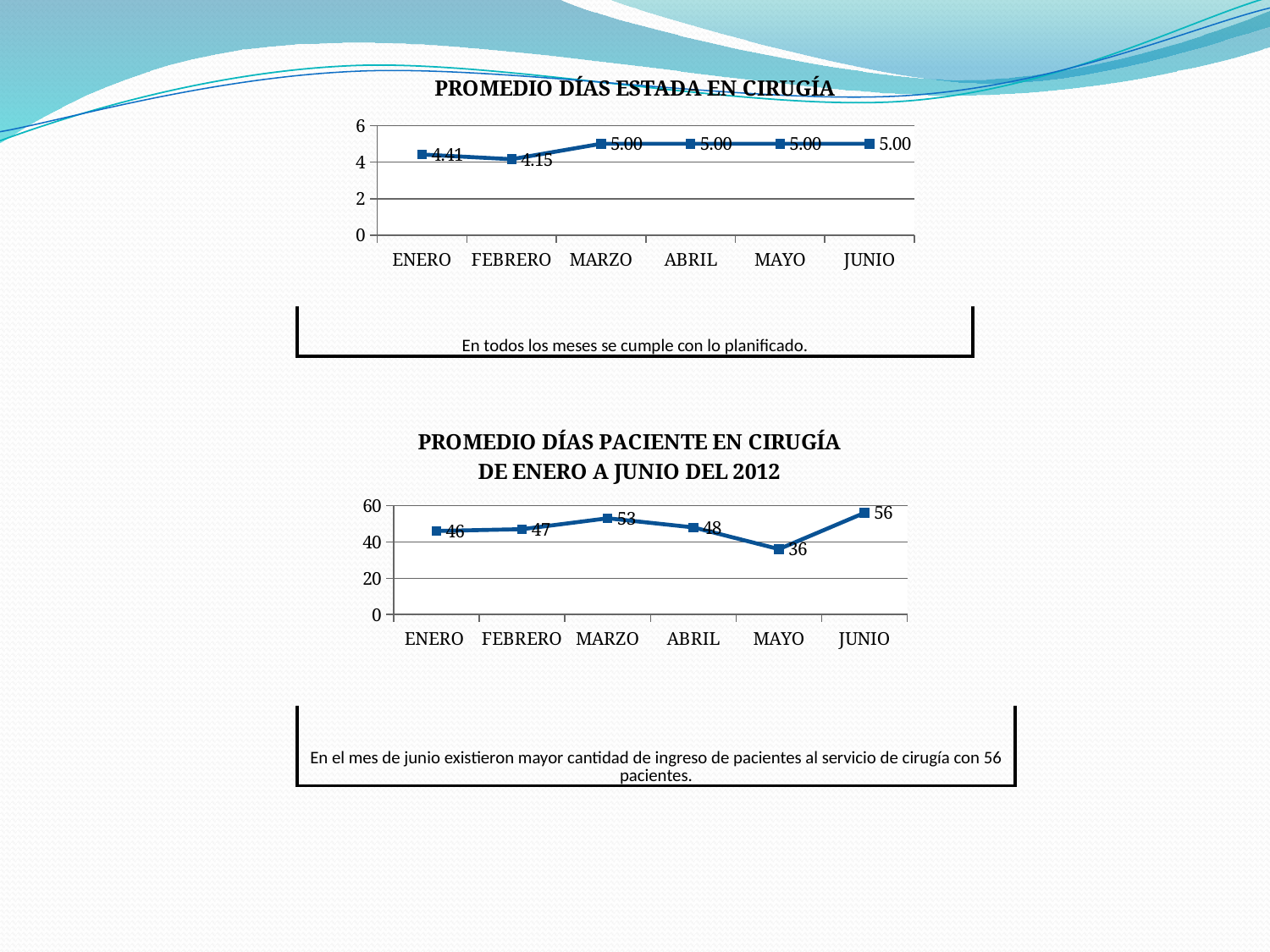
In the chart titled 'PROMEDIO DÍAS PACIENTE EN CIRUGÍA DE ENERO A JUNIO DEL 2012', what is the value for MAYO? 36 In the chart titled 'PROMEDIO DÍAS PACIENTE EN CIRUGÍA DE ENERO A JUNIO DEL 2012', which is larger, the value for MARZO or the value for ABRIL? MARZO In the chart titled 'PROMEDIO DÍAS ESTADA EN CIRUGÍA', what is the value for FEBRERO? 4.15 In the chart titled 'PROMEDIO DÍAS PACIENTE EN CIRUGÍA DE ENERO A JUNIO DEL 2012', is the value for MAYO greater or less than 40? less In the chart titled 'PROMEDIO DÍAS PACIENTE EN CIRUGÍA DE ENERO A JUNIO DEL 2012', which month has the highest value? JUNIO What kind of chart is the chart titled 'PROMEDIO DÍAS ESTADA EN CIRUGÍA'? Line chart In the chart titled 'PROMEDIO DÍAS PACIENTE EN CIRUGÍA DE ENERO A JUNIO DEL 2012', what is the difference between the values for JUNIO and MAYO? 20 In the chart titled 'PROMEDIO DÍAS ESTADA EN CIRUGÍA', which month has the lowest value? FEBRERO In the chart titled 'PROMEDIO DÍAS ESTADA EN CIRUGÍA', what is the difference between the values for MARZO and FEBRERO? 0.85 In the chart titled 'PROMEDIO DÍAS ESTADA EN CIRUGÍA', what is the value for ENERO? 4.41 In the chart titled 'PROMEDIO DÍAS ESTADA EN CIRUGÍA', how many months are plotted? 6 In the chart titled 'PROMEDIO DÍAS PACIENTE EN CIRUGÍA DE ENERO A JUNIO DEL 2012', which month has the lowest value? MAYO